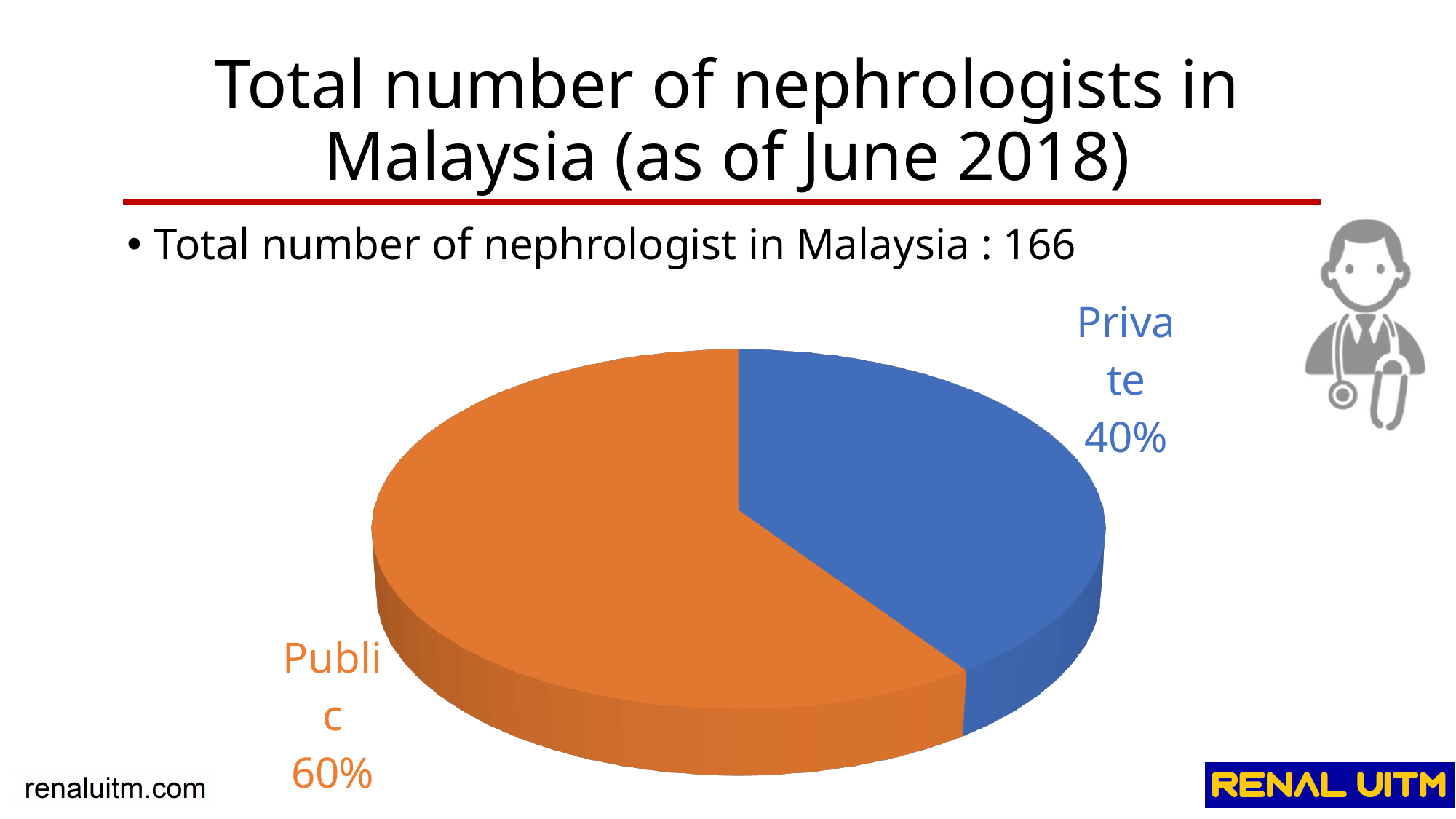
Which slice of the pie is the largest? Public Which slice of the pie is the smallest? Private What percentage of nephrologists are in the Private sector? 40% What share of the pie does the Private slice represent? 40% How many slices does the pie chart have? 2 What colour is the Private slice of the pie? blue Which is larger, the Public slice or the Private slice? Public What is the difference in percentage points between the Public and Private slices? 20% What kind of chart is shown on the slide? pie chart What percentage of nephrologists are in the Public sector? 60% What colour is the Public slice of the pie? orange